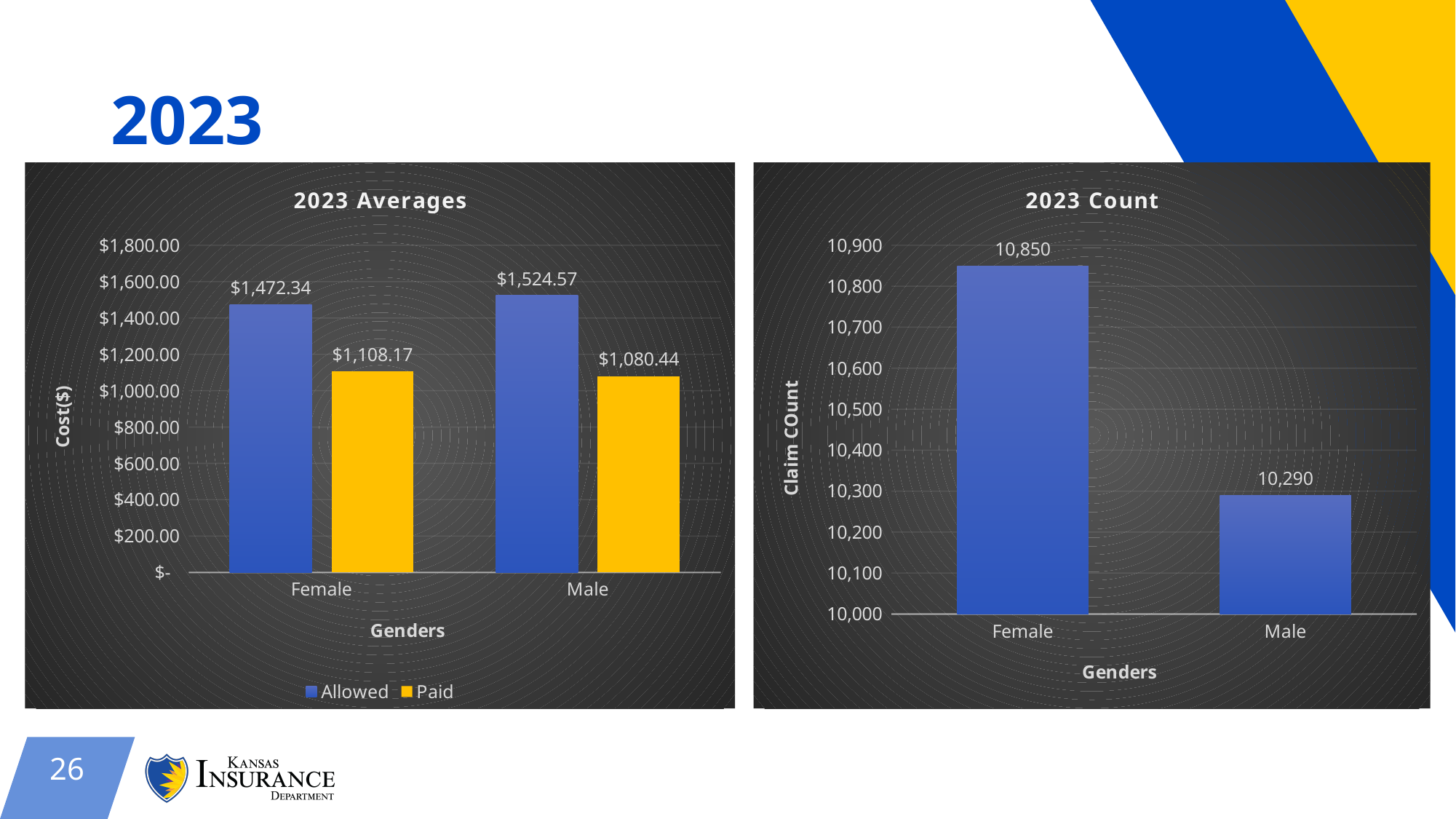
In the '2023 Averages' chart, what is the Paid value for Male? $1,080.44 In the '2023 Averages' chart, what is the y-axis title? Cost($) In the '2023 Count' chart, what is the claim count for Female? 10,850 In the '2023 Count' chart, which gender has the lowest claim count? Male In the '2023 Averages' chart, which gender has the higher Allowed value? Male In the '2023 Count' chart, what is the difference between the Female and Male claim counts? 560 In the '2023 Count' chart, what is the claim count for Male? 10,290 In the '2023 Averages' chart, how many series does the legend list? 2 In the '2023 Averages' chart, what is the difference between the Allowed and Paid values for Male? $444.13 In the '2023 Averages' chart, what is the Paid value for Female? $1,108.17 What kind of chart is the '2023 Count' chart? Bar chart In the '2023 Averages' chart, what is the Allowed value for Female? $1,472.34